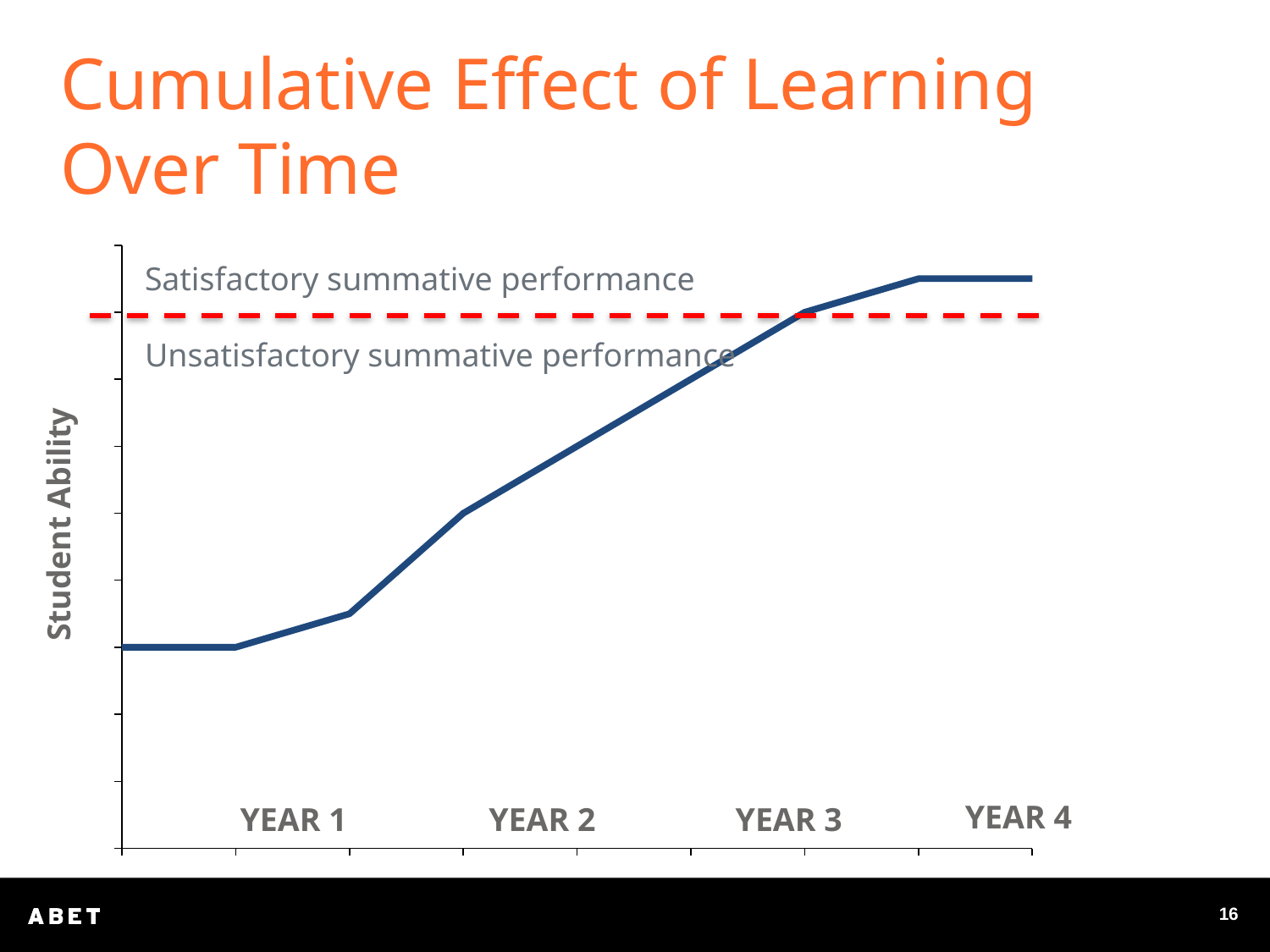
What label appears above the red dashed line? Satisfactory summative performance Does student ability rise or fall from Year 1 to Year 4? Rises What kind of chart is shown on the slide? Line chart How many year labels are shown on the x axis? 4 At which year does the line reach the red dashed threshold? Year 3 Which year has the lowest student ability? Year 1 Is student ability at Year 1 above or below the red dashed line? Below Which year has the highest student ability? Year 4 Which is larger, student ability at Year 2 or at Year 3? Year 3 What is the title of the chart's y axis? Student Ability Is student ability at Year 2 in the satisfactory or unsatisfactory region? Unsatisfactory